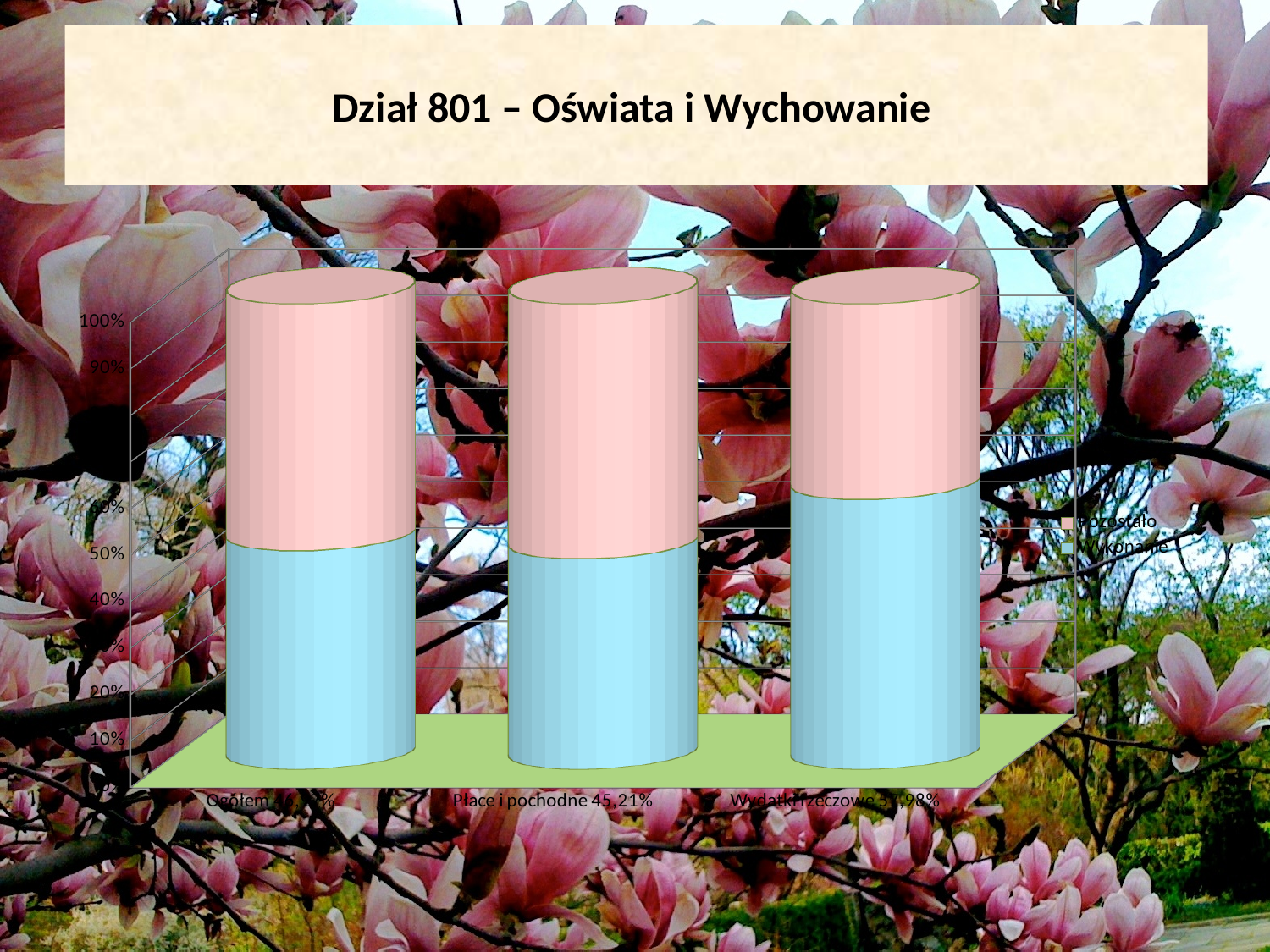
What kind of chart is shown on the slide? bar chart Which has the larger Wykonanie share, Płace i pochodne or Wydatki rzeczowe? Wydatki rzeczowe Which category has the highest Wykonanie share? Wydatki rzeczowe What is the title of the slide? Dział 801 – Oświata i Wychowanie Is the Wykonanie value for Płace i pochodne greater or less than 50%? less What is the Wykonanie percentage shown for Płace i pochodne? 45,21% What are the two series named in the legend? Pozostało and Wykonanie Is the Pozostało portion for Płace i pochodne greater or less than 50%? greater How many series does the legend list? 2 Is the Wykonanie value for Wydatki rzeczowe greater or less than 50%? greater How many categories are plotted on the x axis? 3